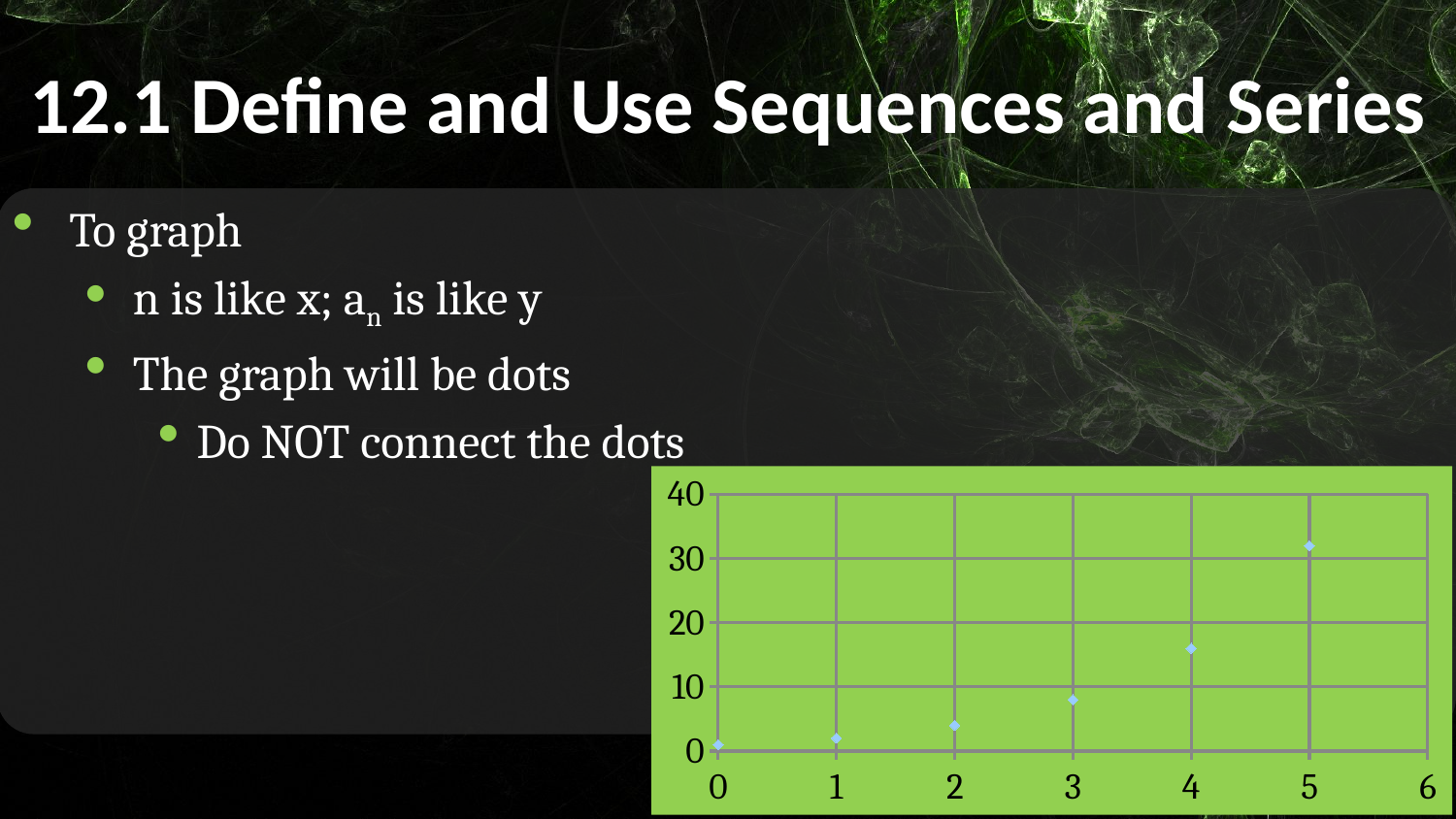
Which point has the larger value, the one at x = 4 or the one at x = 5? x = 5 Is the value of the point at x = 4 greater or less than 10? greater Is the value of the point at x = 4 greater or less than 20? less What is the highest value shown on the chart's x axis? 6 Is the value of the point at x = 5 greater or less than 20? greater What is the highest value shown on the chart's y axis? 40 How many data points are plotted on the chart? 6 At which x value is the plotted point highest? 5 What kind of chart is shown on the slide? scatter plot Do the plotted values rise or fall as the x value increases from 0 to 5? rise